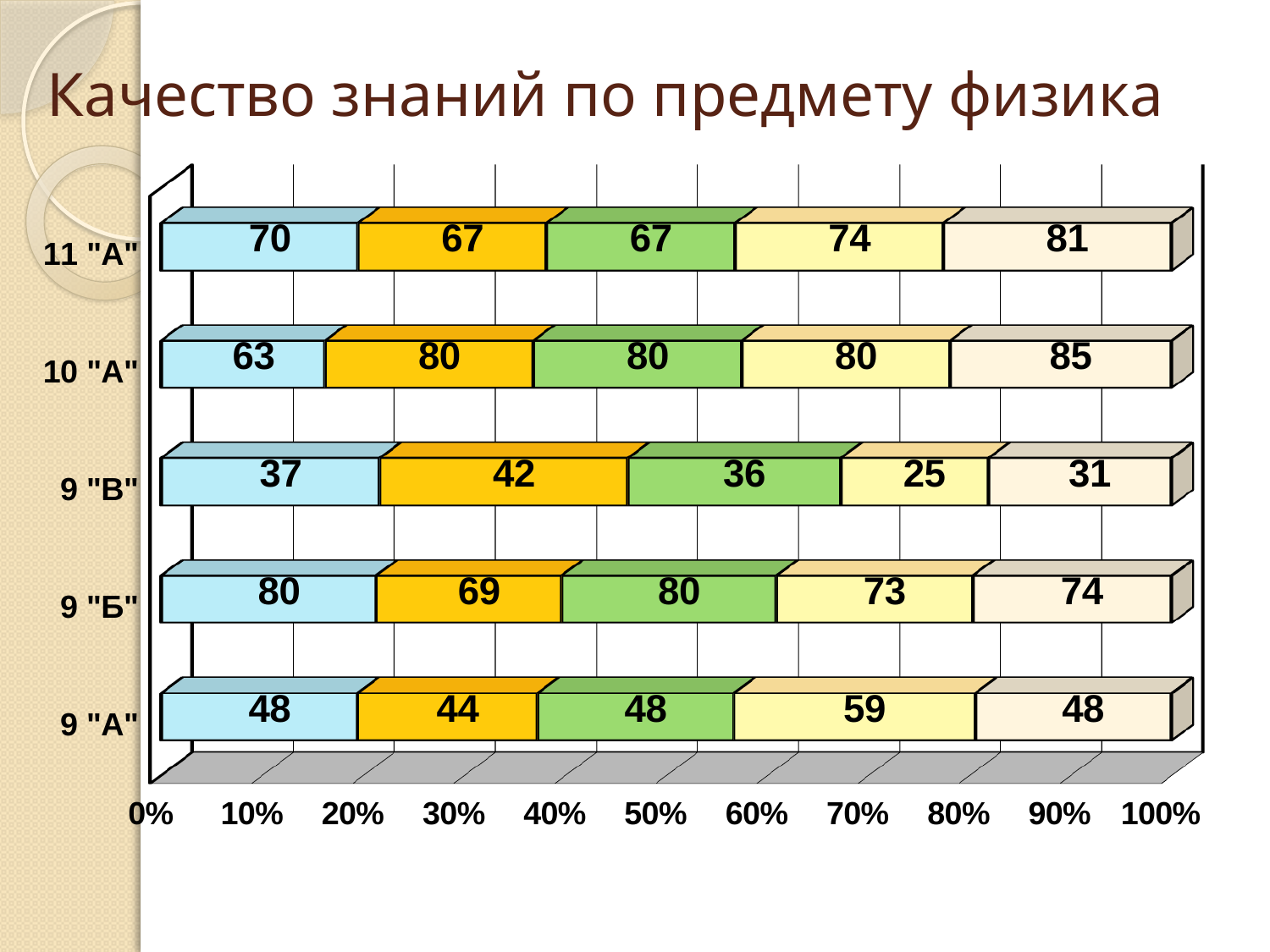
Which is larger: the light blue segment for 9 "Б" or the light blue segment for 9 "А"? 9 "Б" Which segment of the 11 "А" bar has the highest value? The beige segment (81) How many classes (categories) are shown on the chart? 5 What type of chart is shown on the slide? Stacked bar chart What is the value of the first (light blue) segment for 11 "А"? 70 What is the value of the green segment for 9 "Б"? 80 Which segment of the 9 "В" bar has the lowest value? The light yellow segment (25) What is the value of the orange segment for 9 "В"? 42 What is the title of the slide? Качество знаний по предмету физика What is the value of the last (beige) segment for 10 "А"? 85 What is the value of the light yellow segment for 9 "А"? 59 What is the difference between the beige segment values for 10 "А" and 9 "В"? 54